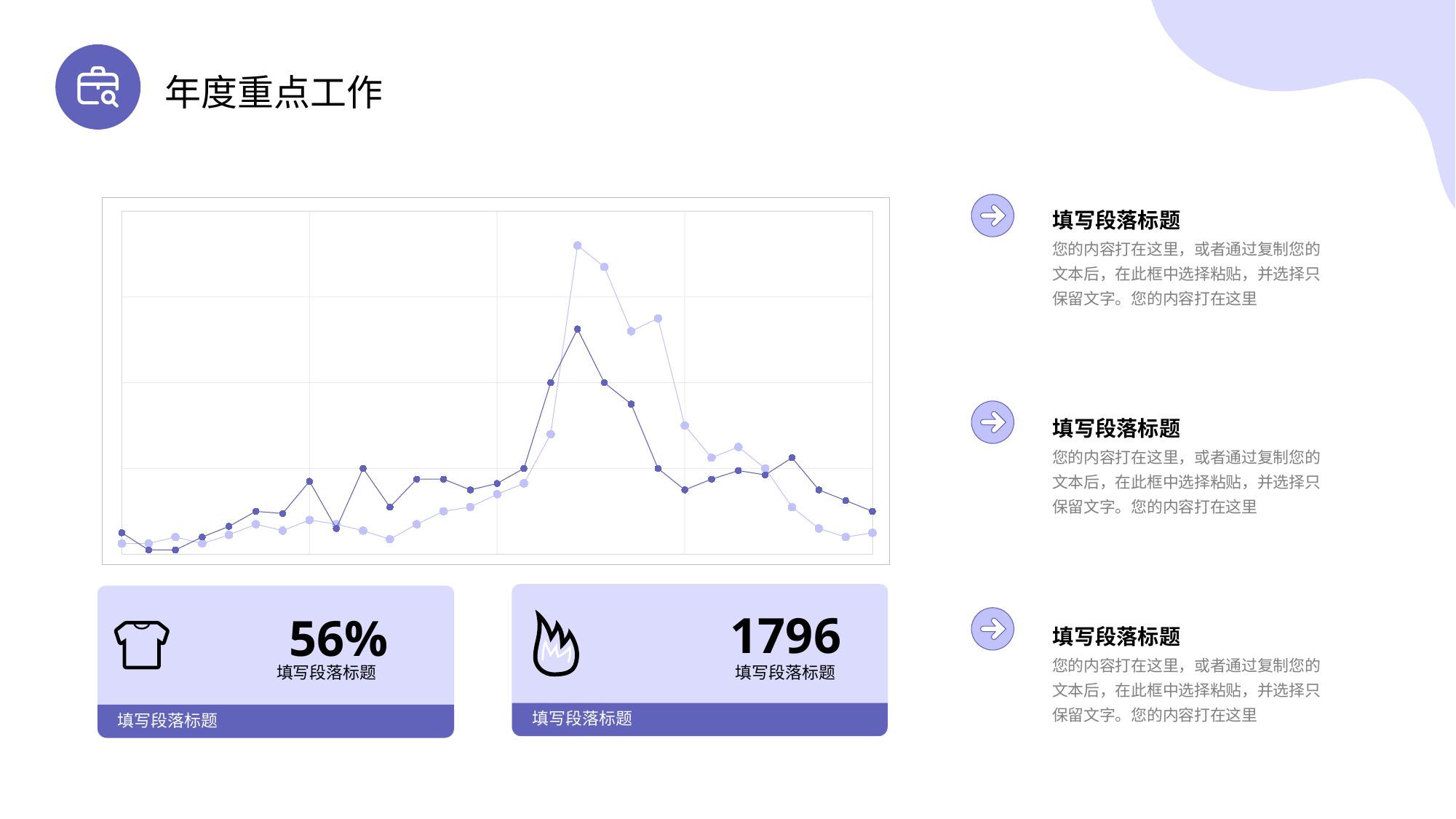
How many lines are plotted in the chart? 2 Does the chart show any axis labels or data labels? No What kind of chart is shown on the slide? line chart Which line reaches the higher peak, the dark purple line or the light lavender line? the light lavender line Does the chart have a legend? No Does the dark purple line end higher or lower than where it starts? higher